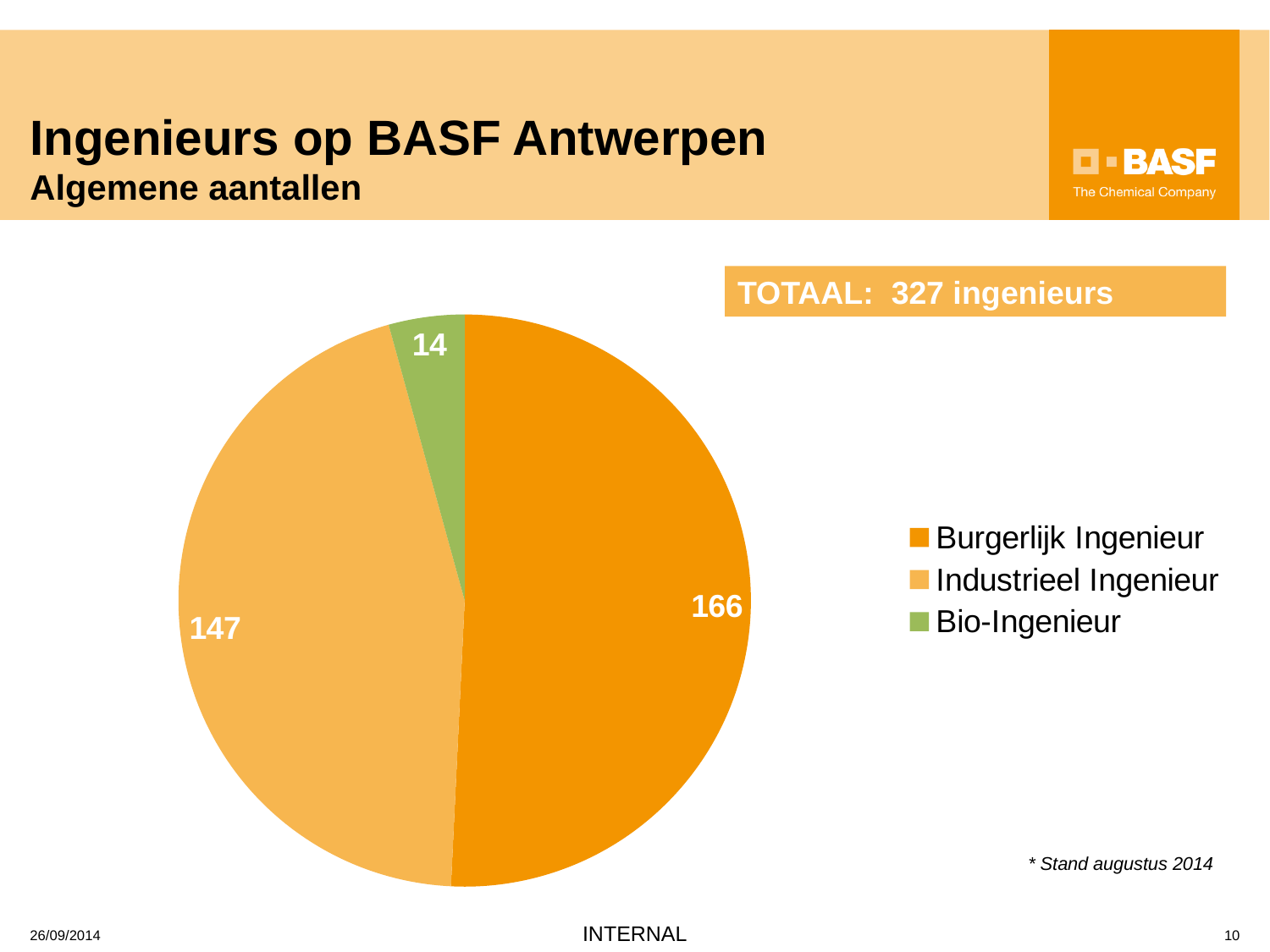
Which category has the smallest slice in the pie chart? Bio-Ingenieur How many Bio-Ingenieur are shown in the pie chart? 14 Which category has the largest slice in the pie chart? Burgerlijk Ingenieur How many categories does the pie chart show? 3 What is the difference between the number of Burgerlijk Ingenieur and Industrieel Ingenieur? 19 How many engineers are Burgerlijk Ingenieur according to the pie chart? 166 What type of chart is shown on the slide? pie chart Which is larger: the number of Burgerlijk Ingenieur or the number of Industrieel Ingenieur? Burgerlijk Ingenieur What is the value shown for Industrieel Ingenieur in the pie chart? 147 What colour is the Bio-Ingenieur slice in the pie chart? green What is the total number of engineers across all slices of the pie chart? 327 What is the difference between the number of Industrieel Ingenieur and Bio-Ingenieur? 133